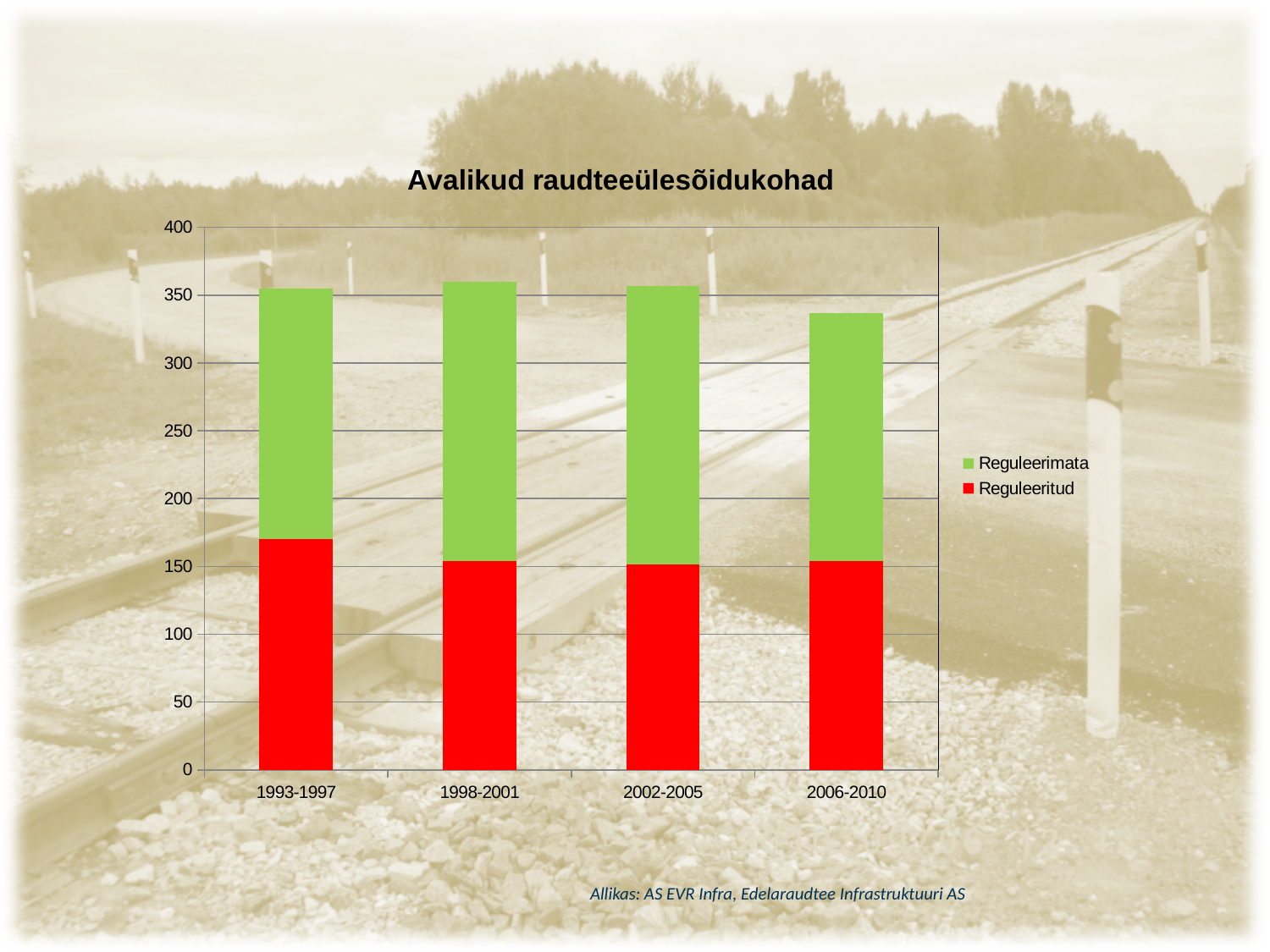
Which is larger, the total bar for 1993-1997 or for 2006-2010? 1993-1997 Is the total bar height for 2006-2010 greater or less than 350? less Which period has the lowest total bar height? 2006-2010 How many series does the legend list? 2 What is the title of the chart? Avalikud raudteeülesõidukohad Which colour represents the Reguleeritud series? Red What kind of chart is shown on the slide? Stacked bar chart Is the Reguleeritud value for 1993-1997 greater or less than 150? greater How many period categories are shown on the x axis? 4 Is the total bar height for 1998-2001 greater or less than 350? greater Which is larger, the Reguleeritud value for 1993-1997 or for 2006-2010? 1993-1997 Which period has the highest Reguleeritud (red) value? 1993-1997